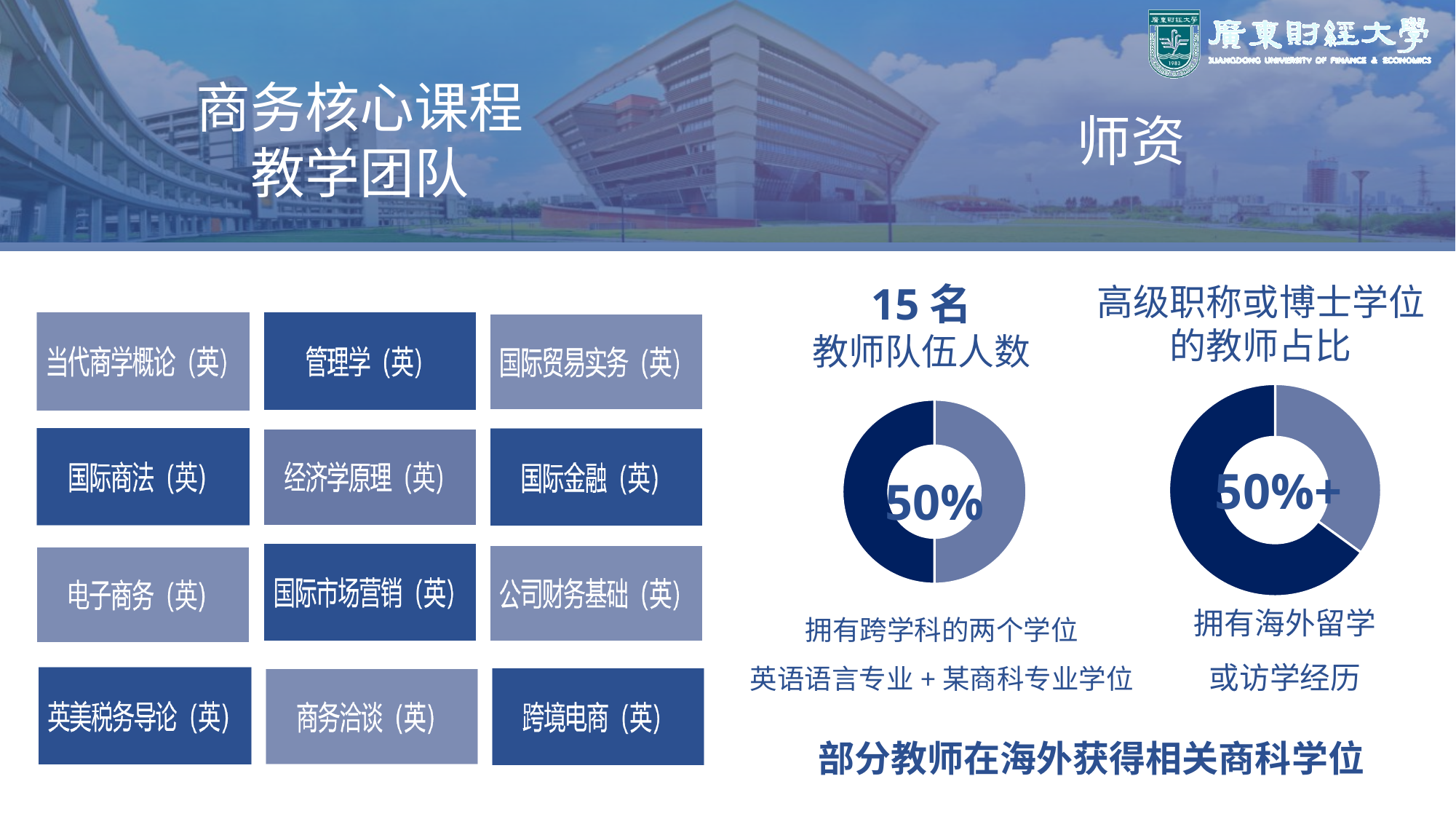
In the right chart (高级职称或博士学位的教师占比), what value is printed in the centre? 50%+ In the left chart (教师队伍人数), what percentage is printed in the centre? 50% How many slices does the right donut chart (高级职称或博士学位的教师占比) have? 2 What kind of chart is the left chart under "15 名 教师队伍人数"? Donut (pie) chart What is the total number of teachers stated above the left chart? 15 名 What kind of chart is the right chart under "高级职称或博士学位的教师占比"? Donut (pie) chart How many slices does the left donut chart (教师队伍人数) have? 2 What caption appears below the left chart (教师队伍人数)? 拥有跨学科的两个学位 英语语言专业 + 某商科专业学位 In the right chart (高级职称或博士学位的教师占比), is the dark blue slice greater or less than 50% of the donut? greater What caption appears below the right chart (高级职称或博士学位的教师占比)? 拥有海外留学或访学经历 In the right chart (高级职称或博士学位的教师占比), which slice is larger, the dark blue one or the light grey-blue one? The dark blue one